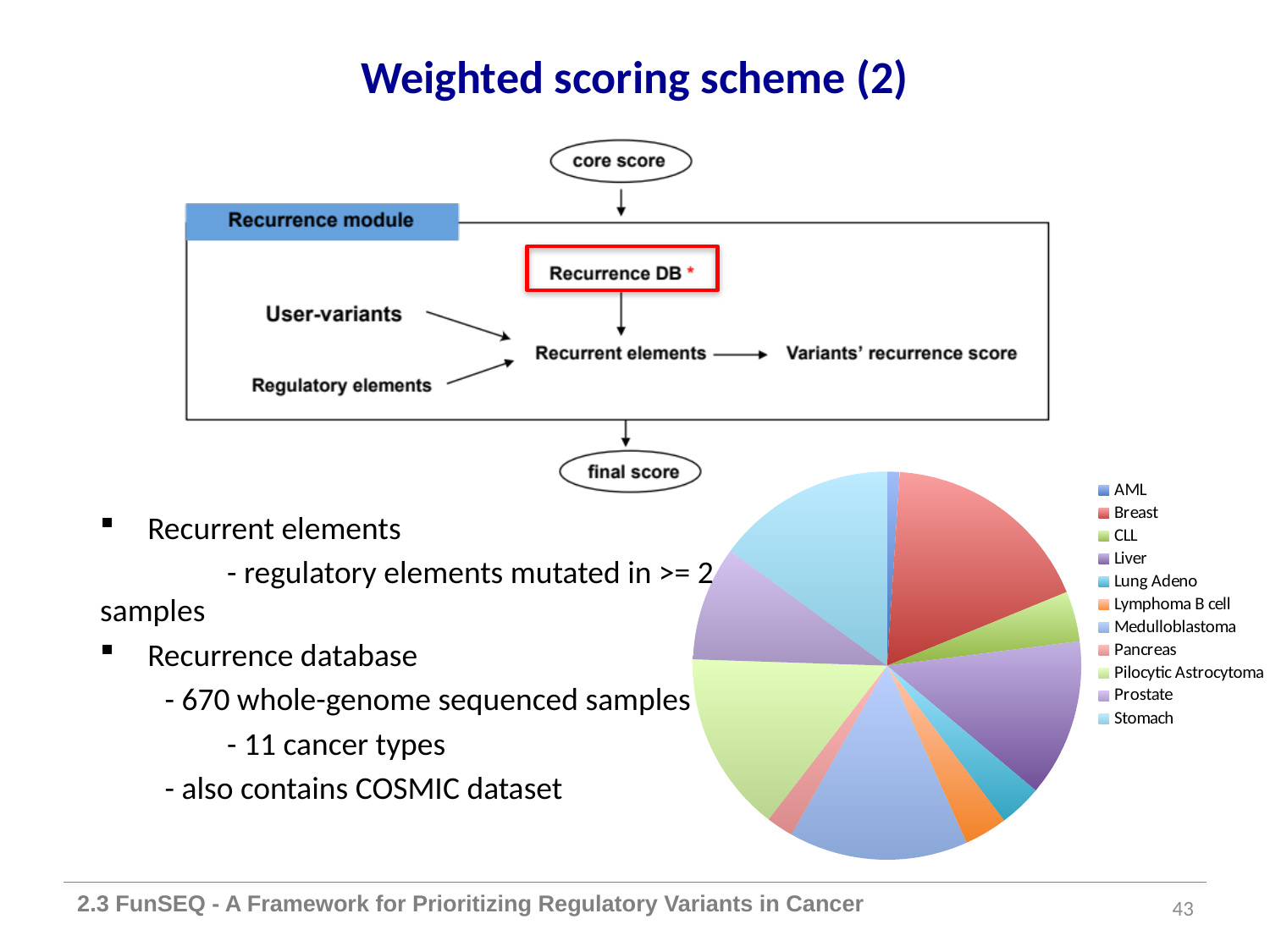
How many cancer types (slices) does the pie chart show? 11 Which slice is larger in the pie chart, Medulloblastoma or AML? Medulloblastoma How many entries does the pie chart's legend list? 11 What kind of chart is shown on the slide? pie chart What colour is the Breast slice in the pie chart? red Which slice is larger in the pie chart, Liver or Lymphoma B cell? Liver Which slice is larger in the pie chart, Prostate or Pancreas? Prostate Which legend entry is listed first in the pie chart's legend? AML Which cancer type has the smallest slice in the pie chart? AML